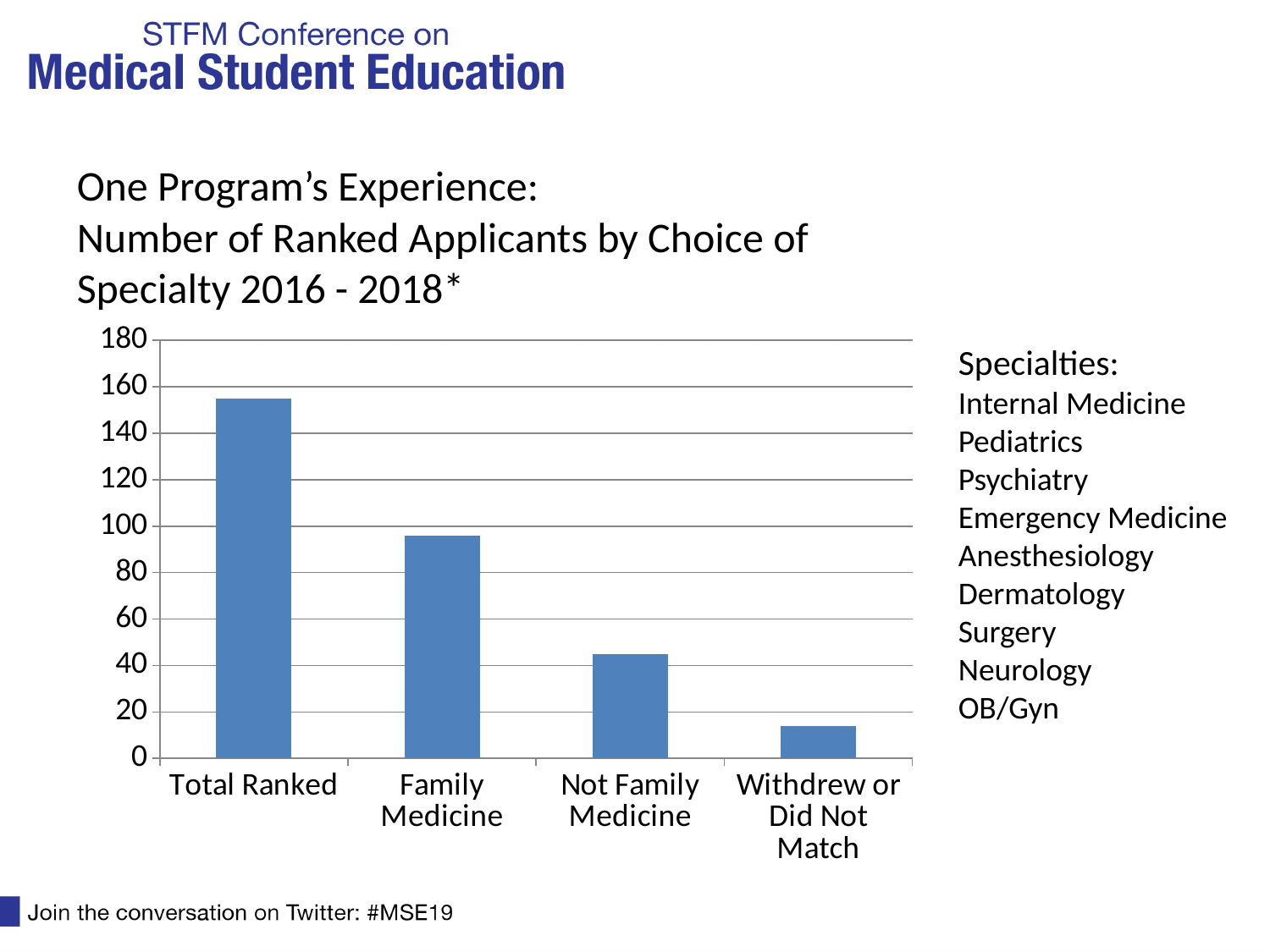
Which category has the lowest bar in the chart? Withdrew or Did Not Match Is the value for Family Medicine greater or less than 100? less What kind of chart is shown on the slide? bar chart Do the bar values rise or fall moving from left to right along the x axis? fall Is the value for Total Ranked greater or less than 160? less Which is larger, the value for Family Medicine or the value for Not Family Medicine? Family Medicine Which category has the highest bar in the chart? Total Ranked How many categories are shown on the x axis of the chart? 4 Is the value for Withdrew or Did Not Match greater or less than 20? less